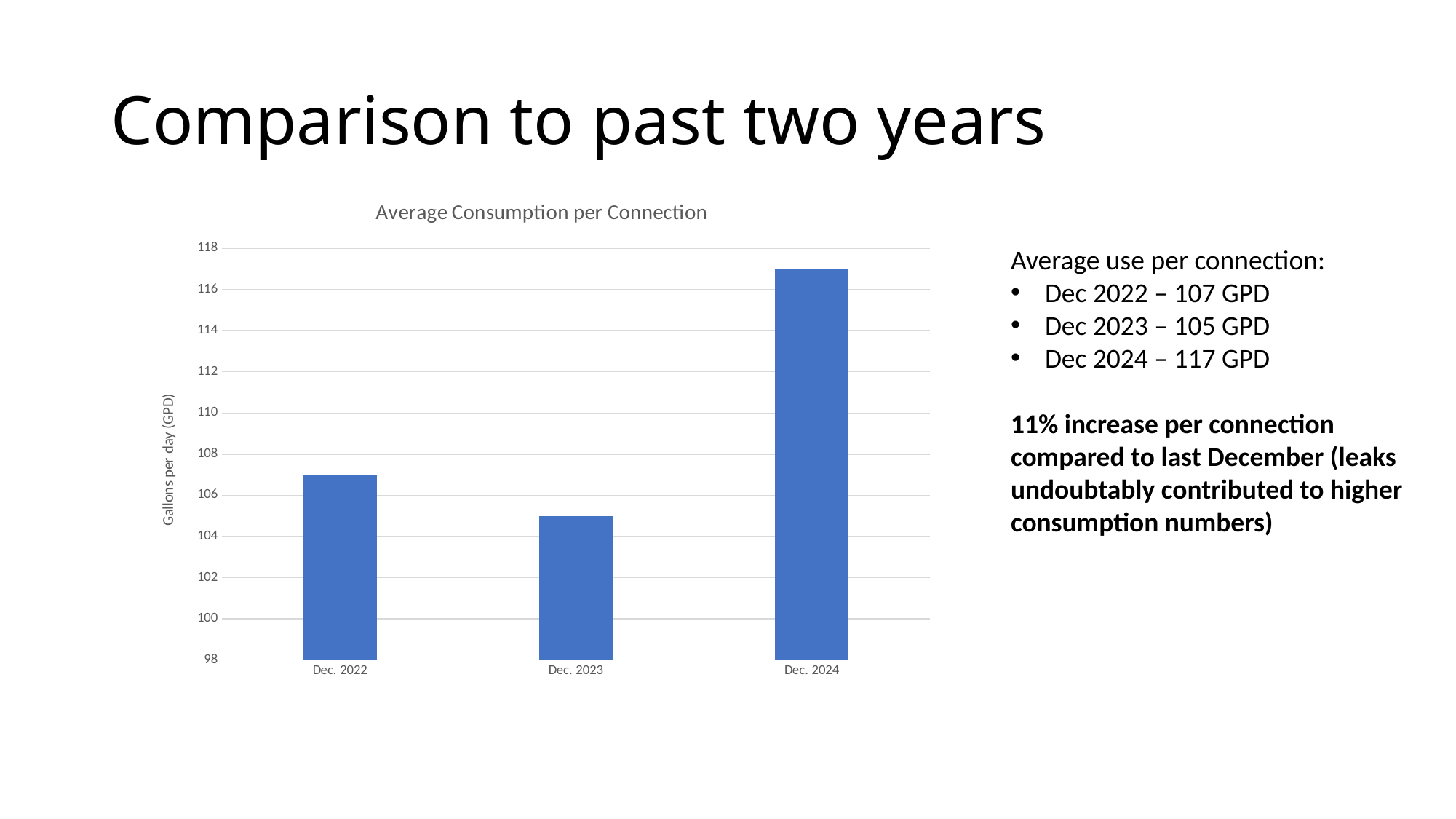
What is the average consumption per connection for Dec. 2022? 107 GPD Which category has the lowest average consumption per connection? Dec. 2023 What is the average consumption per connection for Dec. 2024? 117 GPD Is the value for Dec. 2023 greater or less than 106? less Is the value for Dec. 2024 greater or less than 110? greater How many bars (categories) does the chart show? 3 What is the difference between the Dec. 2024 and Dec. 2023 values? 12 GPD Which category has the highest average consumption per connection? Dec. 2024 Which is larger, the value for Dec. 2022 or Dec. 2023? Dec. 2022 What is the label of the vertical axis? Gallons per day (GPD) What type of chart is shown on the slide? bar chart What is the title of the chart? Average Consumption per Connection